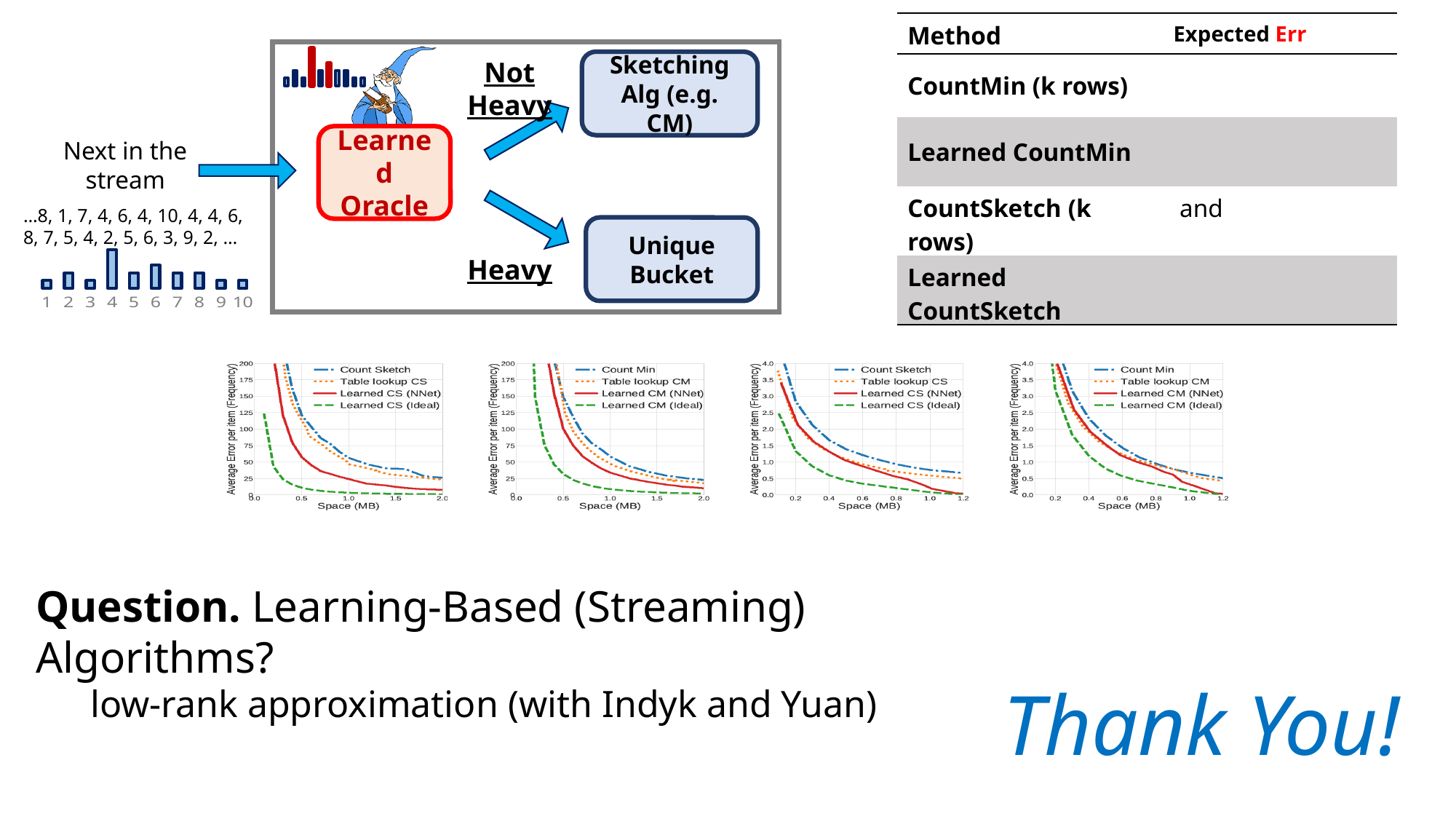
In the leftmost bottom chart, do the values of the Count Sketch series rise or fall as Space (MB) increases? fall How many categories are shown on the x axis of the small bar chart in the top-left of the slide? 10 In the leftmost bottom chart, which series has the lowest error across the plotted range? Learned CS (Ideal) In the third bottom chart from the left, which series is higher at 0.6 MB: Count Sketch or Learned CS (Ideal)? Count Sketch What kind of chart is the leftmost of the four charts at the bottom of the slide? line chart In the rightmost bottom chart, which series has the lowest error across the plotted range? Learned CM (Ideal) What is the y-axis label of the rightmost bottom chart? Average Error per item (Frequency) How many series does the legend of the leftmost bottom chart list? 4 In the second bottom chart from the left, what is the label of the x axis? Space (MB) In the rightmost bottom chart, is the value of Learned CM (Ideal) at 0.8 MB greater or less than 1.0? less In the leftmost bottom chart, is the value of Learned CS (Ideal) at 1.0 MB greater or less than 25? less In the small bar chart in the top-left of the slide, which category has the tallest bar? 4